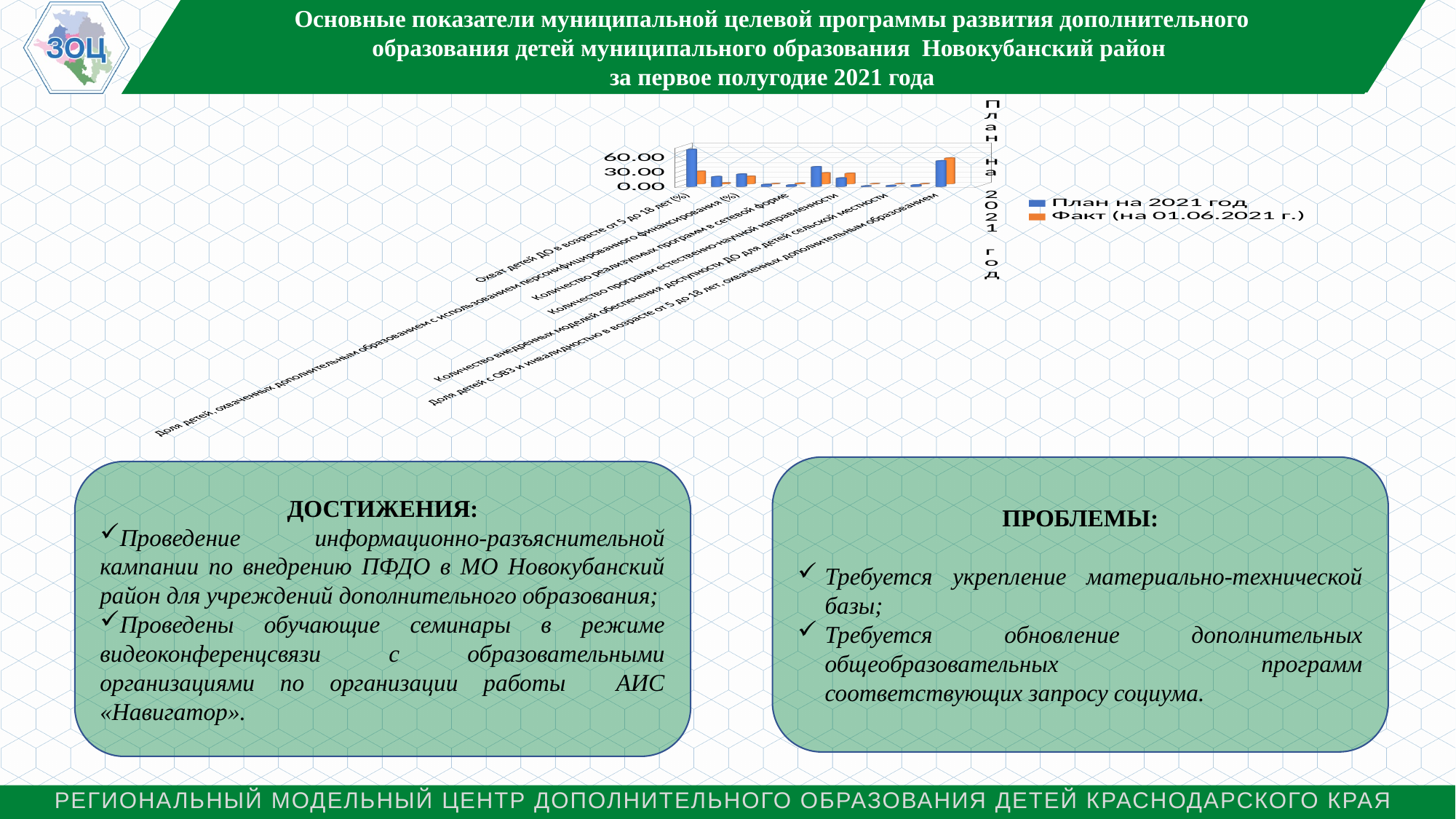
What is the highest tick value shown on the chart's vertical axis? 60.00 What kind of chart is shown on the slide? bar chart What colour represents the series 'Факт (на 01.06.2021 г.)' in the chart? orange What are the two series named in the chart legend? План на 2021 год; Факт (на 01.06.2021 г.) How many series does the chart legend list? 2 Is the 'План на 2021 год' value for 'Охват детей ДО в возрасте от 5 до 18 лет (%)' greater or less than 30? greater For 'Доля детей, охваченных дополнительным образованием с использованием персонифицированного финансирования (%)', which is larger: the 'План на 2021 год' value or the 'Факт (на 01.06.2021 г.)' value? План на 2021 год Is the 'Факт (на 01.06.2021 г.)' value for 'Доля детей, охваченных дополнительным образованием с использованием персонифицированного финансирования (%)' greater or less than 30? less Which category has the highest 'План на 2021 год' value? Охват детей ДО в возрасте от 5 до 18 лет (%)